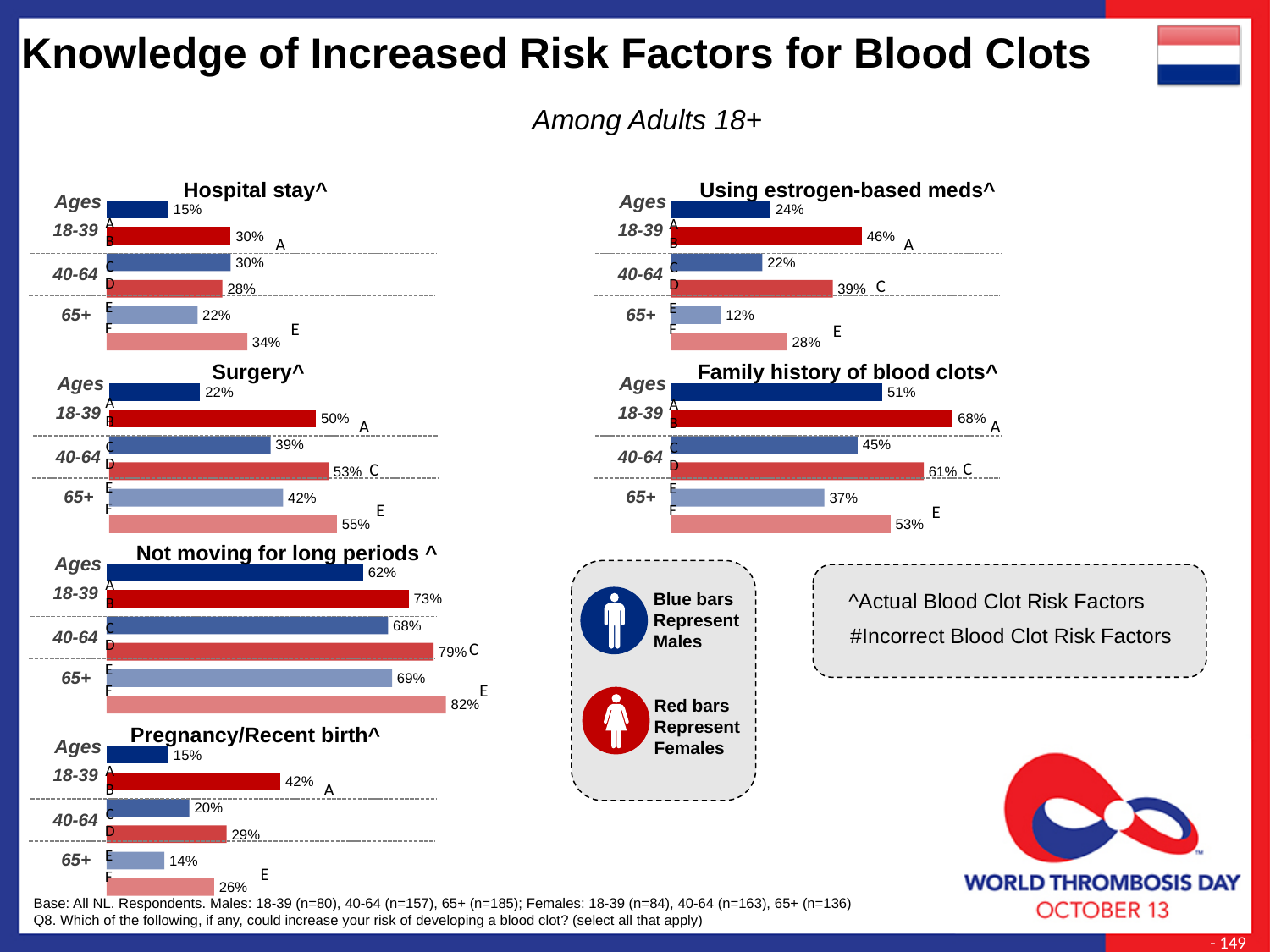
In the 'Surgery^' chart, which bar has the highest value? Females 65+ (55%) In the 'Hospital stay^' chart, what is the value for females aged 65+? 34% In the 'Surgery^' chart, what is the difference between females aged 18-39 and males aged 18-39? 28 percentage points In the 'Not moving for long periods ^' chart, which bar has the lowest value? Males 18-39 (62%) In the 'Family history of blood clots^' chart, what is the value for females aged 18-39? 68% In the 'Not moving for long periods ^' chart, what is the value for females aged 65+? 82% What type of chart is used for 'Hospital stay^'? Bar chart In the 'Using estrogen-based meds^' chart, what is the value for males aged 65+? 12% In the 'Hospital stay^' chart, what is the value for males aged 18-39? 15% In the 'Family history of blood clots^' chart, what is the difference between females aged 40-64 and males aged 40-64? 16 percentage points In the 'Pregnancy/Recent birth^' chart, which is larger: females aged 18-39 or females aged 40-64? Females aged 18-39 (42%) How many bars are shown in the 'Surgery^' chart? 6